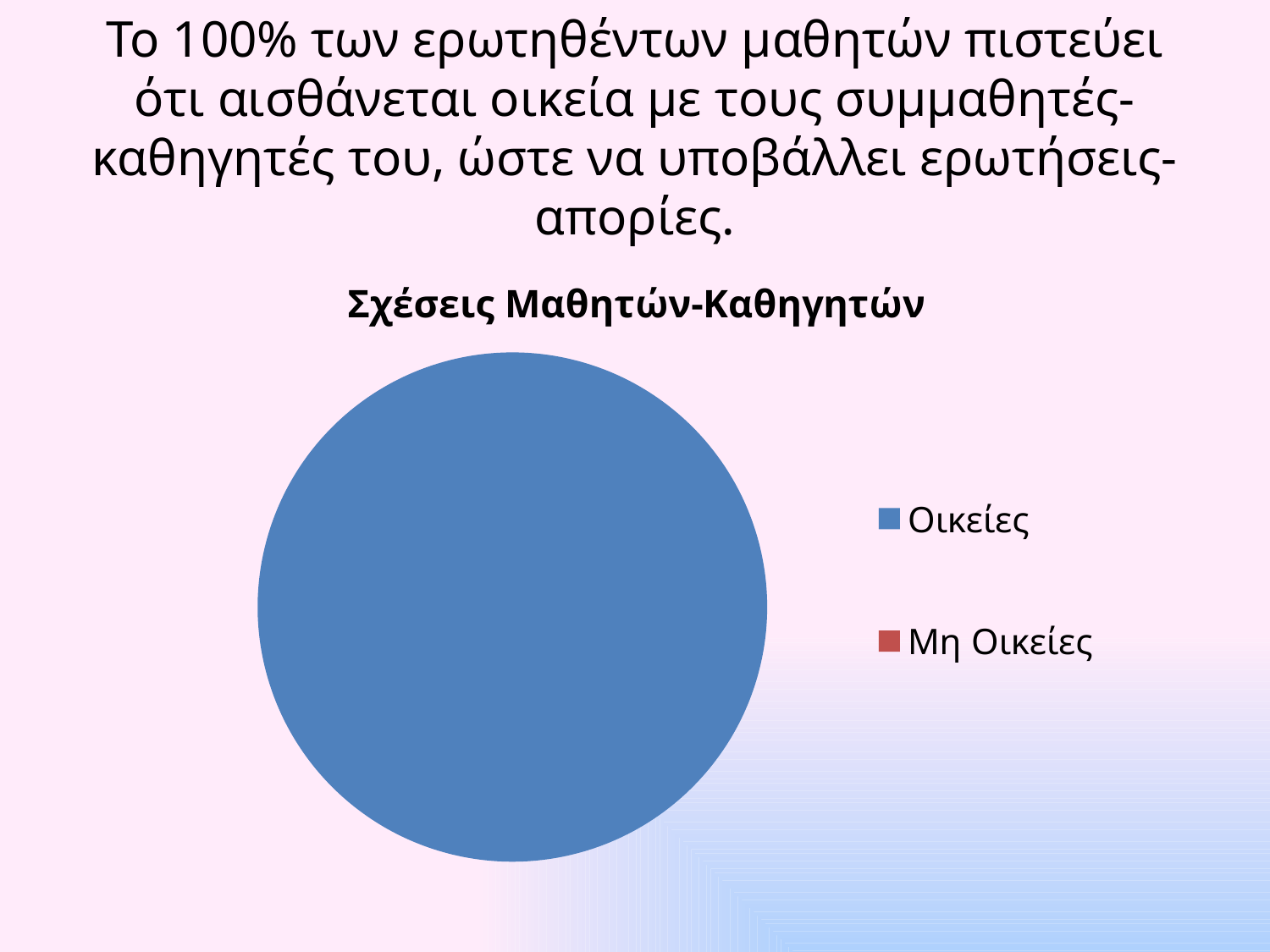
Which is larger, the slice for Οικείες or the slice for Μη Οικείες? Οικείες Which category has the smallest slice of the pie? Μη Οικείες Is the slice for Μη Οικείες visible in the pie? no Which category has the largest slice of the pie? Οικείες How many entries does the chart's legend list? 2 What share of the pie does Οικείες take up? 100% What colour is the slice for Οικείες? blue What is the title of the chart? Σχέσεις Μαθητών-Καθηγητών What kind of chart is shown on the slide? pie chart